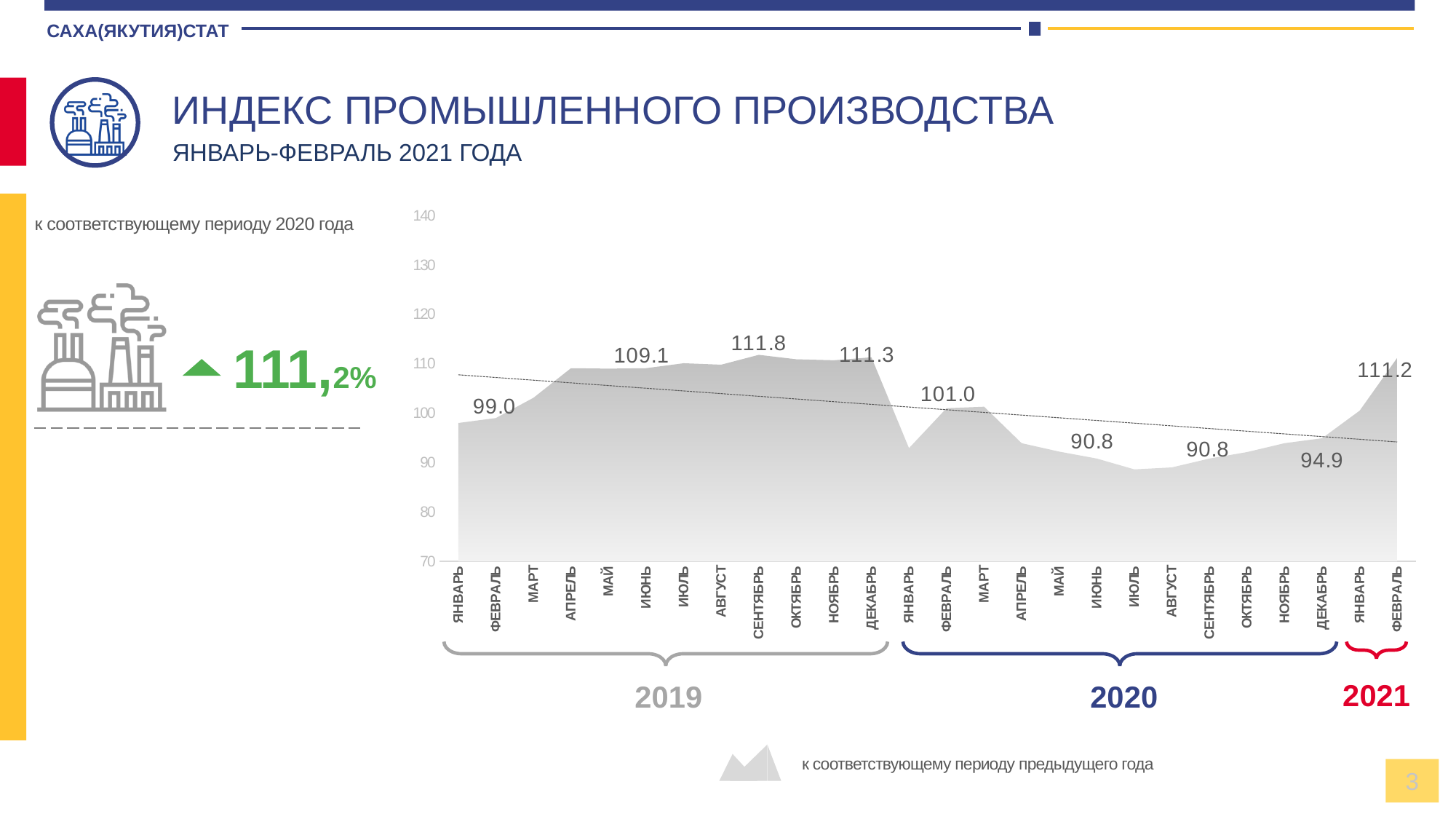
How many monthly points are plotted on the chart? 26 What is the lowest data label shown on the chart? 90.8 What is the highest data label shown on the chart? 111.8 What type of chart is shown on the slide? area chart Is the value for January 2020 greater or less than 100? less What is the value of the index for February 2021 (the last point on the chart)? 111.2 Do the values rise or fall from November 2020 to February 2021? rise Which is larger: the labelled value 101.0 in 2020 or the labelled value 94.9 in 2020? 101.0 What percentage is shown in large green text on the left of the slide? 111,2% What is the difference between the highest labelled value (111.8) and the lowest labelled value (90.8)? 21.0 Is the value for April 2019 greater or less than 100? greater